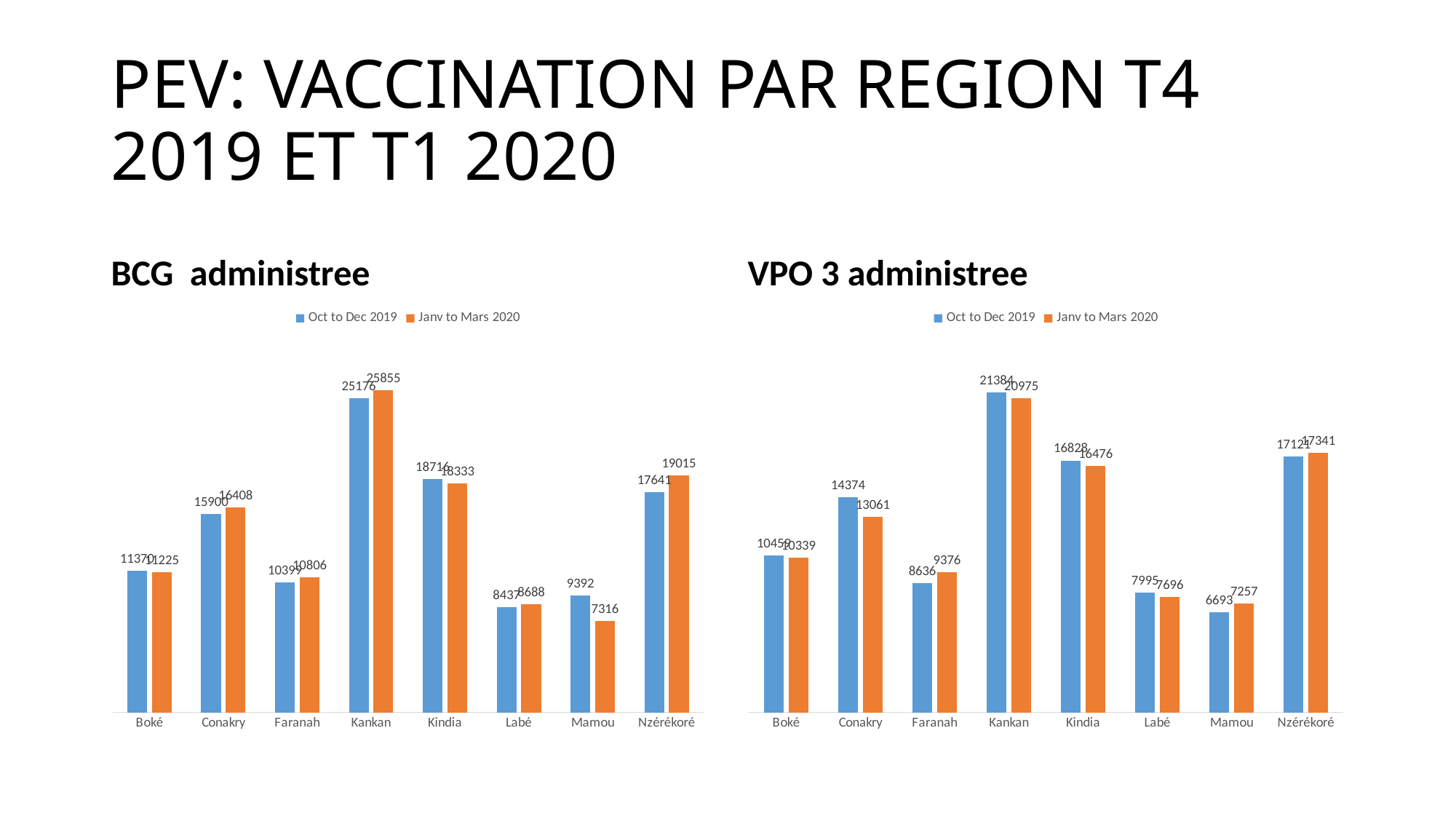
In the BCG administree chart, which region has the highest value for Janv to Mars 2020? Kankan How many series does the legend of the VPO 3 administree chart list? 2 In the VPO 3 administree chart, what is the value for Kankan for Oct to Dec 2019? 21384 How many regions are shown on the x axis of the BCG administree chart? 8 In the VPO 3 administree chart, what is the difference between the Oct to Dec 2019 and Janv to Mars 2020 values for Conakry? 1313 In the BCG administree chart, what is the value for Kankan for Oct to Dec 2019? 25176 In the BCG administree chart, what is the value for Nzérékoré for Janv to Mars 2020? 19015 In the BCG administree chart, what is the difference between the Oct to Dec 2019 and Janv to Mars 2020 values for Mamou? 2076 In the BCG administree chart, which region has the lowest value for Janv to Mars 2020? Mamou In the VPO 3 administree chart, which is larger for Faranah: Oct to Dec 2019 or Janv to Mars 2020? Janv to Mars 2020 In the VPO 3 administree chart, what is the value for Conakry for Janv to Mars 2020? 13061 In the VPO 3 administree chart, which region has the lowest value for Oct to Dec 2019? Mamou